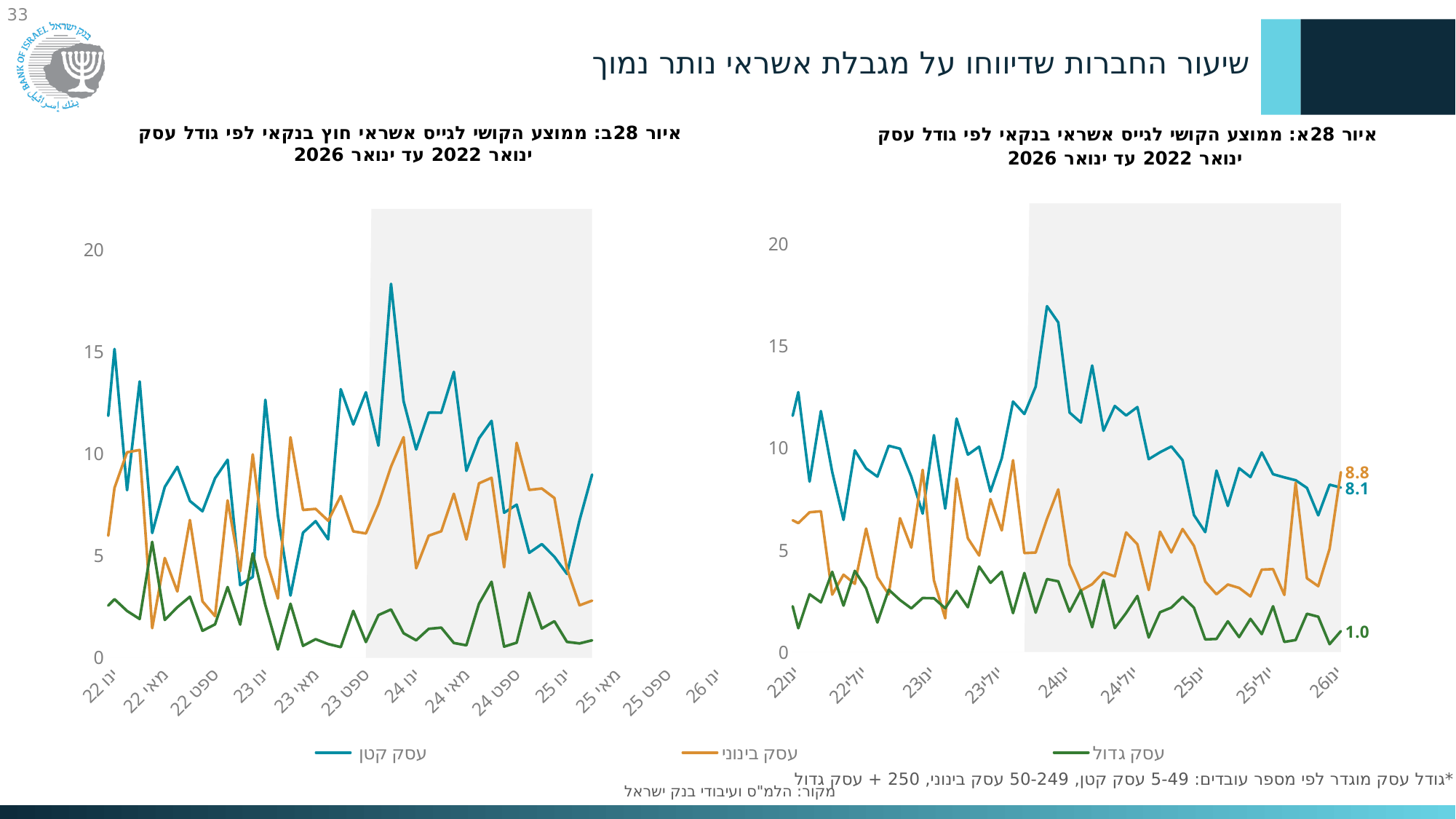
In איור 28א (the right chart), what is the difference between the final labelled values for עסק בינוני and עסק קטן? 0.7 In איור 28א (the right chart), does the עסק קטן line generally rise or fall from its peak around ינו 24 to ינו 26? fall In איור 28ב (the left chart), is the peak value of עסק קטן around ינו 24 greater or less than 15? greater How many series does the legend list for the charts? 3 What kind of chart is shown in איור 28א (the right chart)? line chart In איור 28א (the right chart), at the end of the period, which is larger: the value for עסק בינוני or for עסק קטן? עסק בינוני In איור 28א (the right chart), which series has the lowest value at the end of the period? עסק גדול What colour is the line for עסק בינוני in the charts? orange In איור 28א (the right chart), what is the final labelled value for עסק קטן? 8.1 In איור 28א (the right chart), what is the difference between the final labelled values for עסק בינוני and עסק גדול? 7.8 In איור 28א (the right chart), what is the final labelled value for עסק בינוני? 8.8 In איור 28א (the right chart), what is the final labelled value for עסק גדול? 1.0